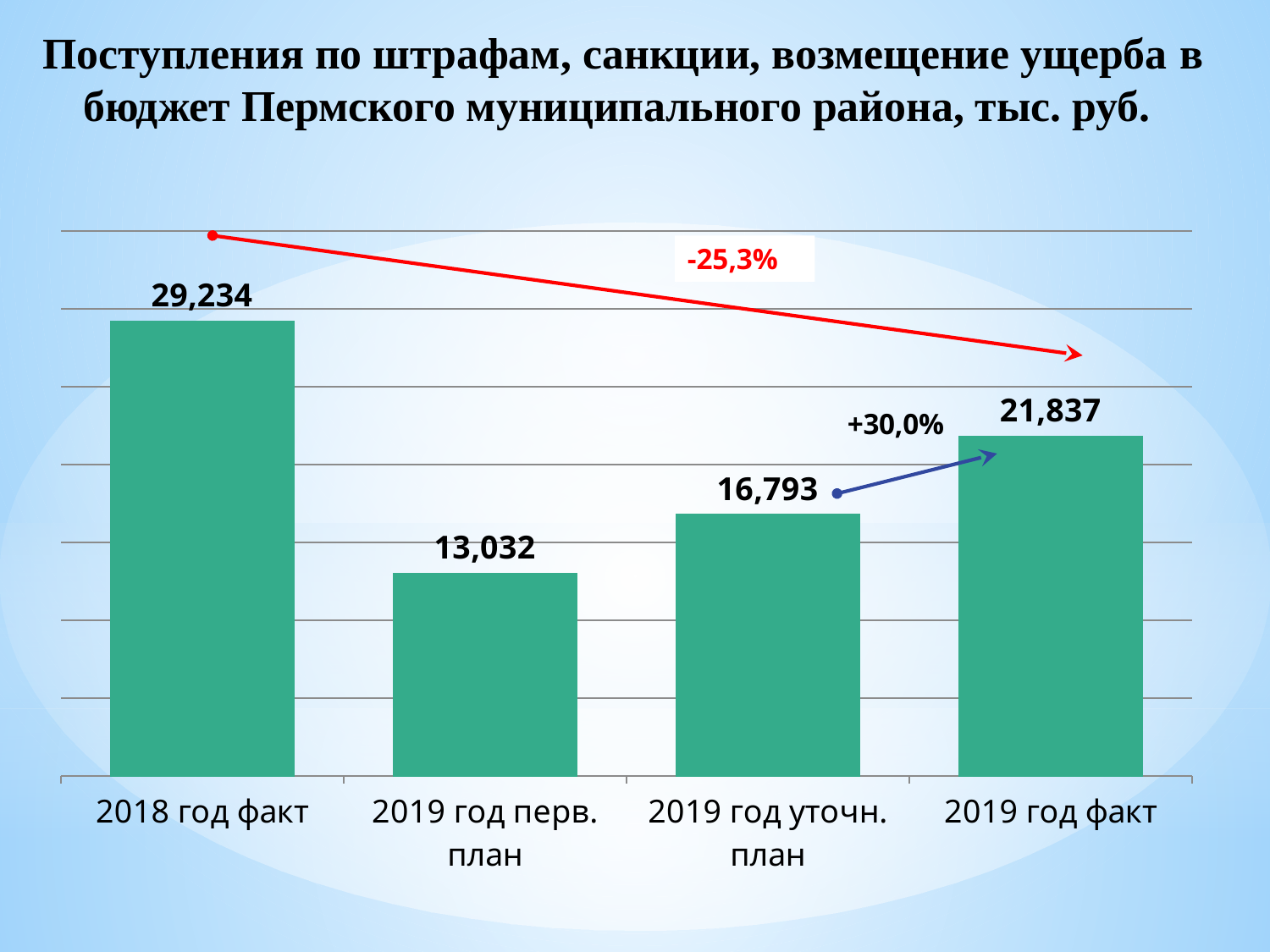
Which is larger, the value for 2019 год уточн. план or the value for 2019 год факт? 2019 год факт What kind of chart is shown on the slide? bar chart What is the difference between the values for 2019 год уточн. план and 2019 год перв. план? 3,761 What is the value for 2019 год перв. план? 13,032 What is the difference between the values for 2018 год факт and 2019 год факт? 7,397 What is the value for 2018 год факт? 29,234 Which category has the lowest value? 2019 год перв. план What is the value for 2019 год факт? 21,837 What is the value for 2019 год уточн. план? 16,793 Which category has the highest value? 2018 год факт How many categories are shown on the chart? 4 What percentage change is shown by the red arrow from 2018 год факт to 2019 год факт? -25,3%